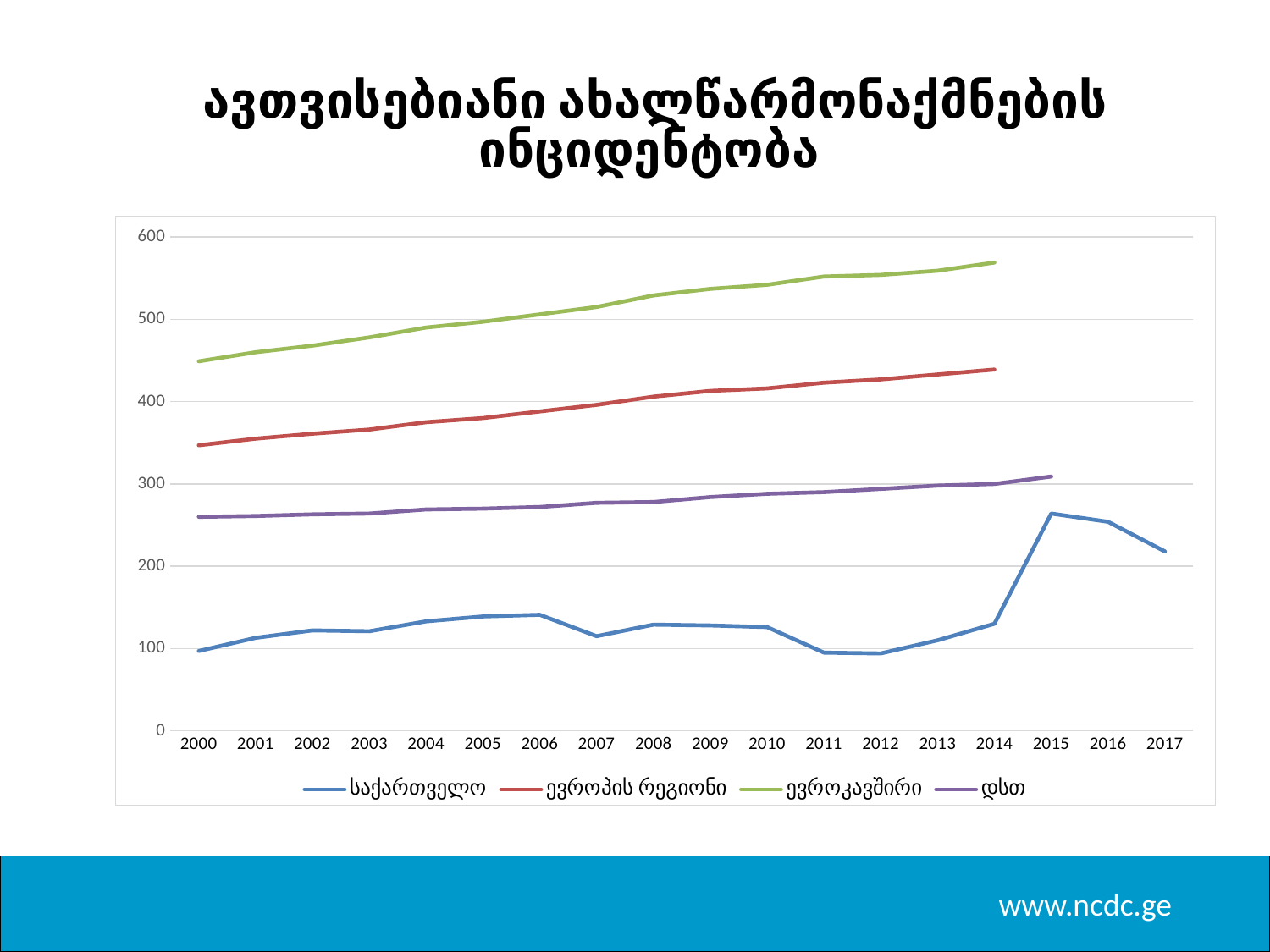
Is the value for ევროპის რეგიონი in 2000 greater or less than 400? less Is the value for ევროკავშირი in 2014 greater or less than 500? greater Which series has the lowest values across the chart? საქართველო How many series does the legend list? 4 What kind of chart is shown on the slide? line chart Is the value for დსთ in 2015 greater or less than 300? greater Does the ევროკავშირი series rise or fall from 2000 to 2014? rise Which is larger in 2010: the value for ევროპის რეგიონი or the value for დსთ? ევროპის რეგიონი Which series is drawn in blue? საქართველო How many years are shown on the x axis? 18 Which series has the highest values across the chart? ევროკავშირი